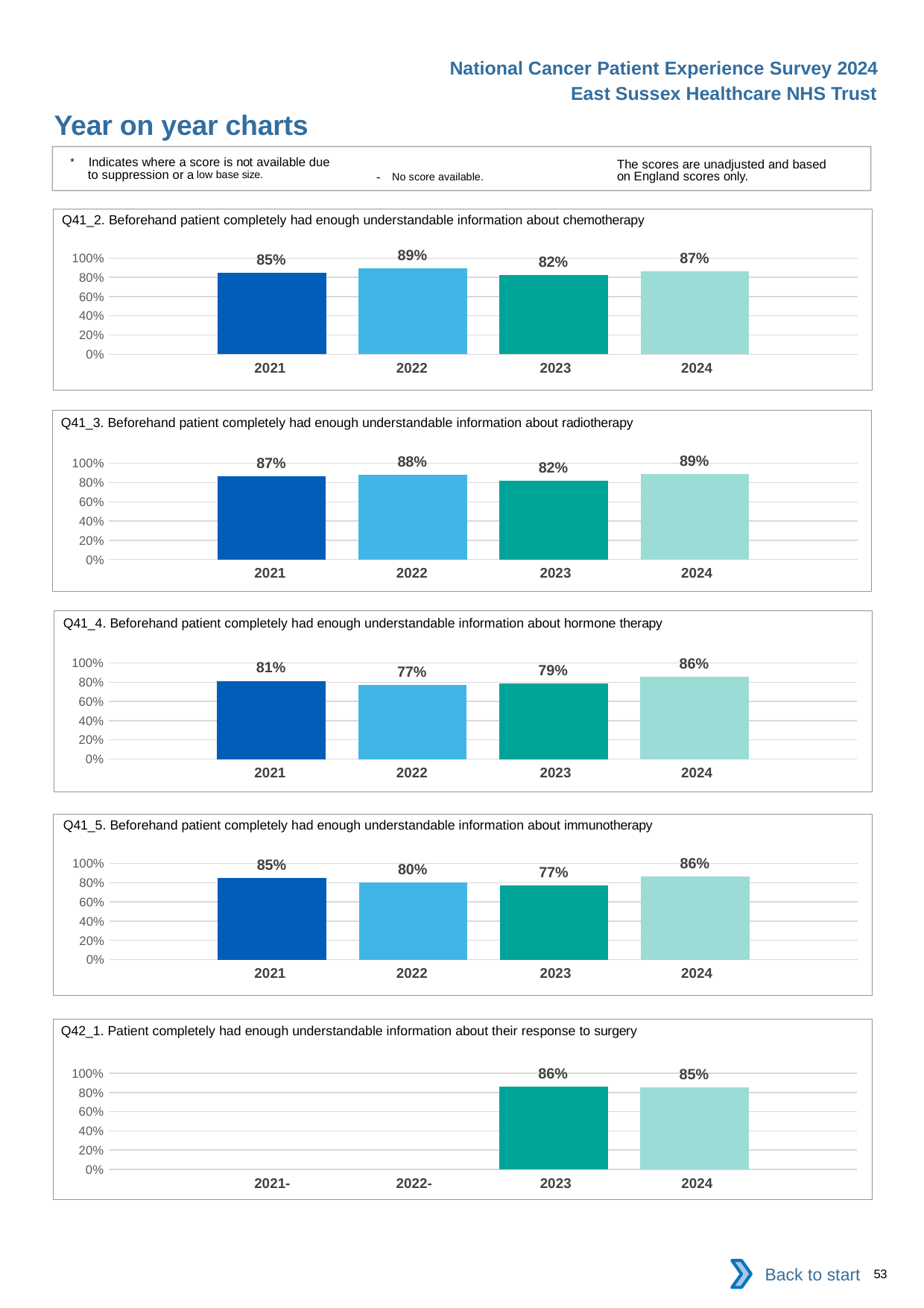
In the Q41_5 chart (immunotherapy), which is larger, the value for 2021 or the value for 2023? 2021 In the Q41_3 chart (radiotherapy), what is the value for 2024? 89% In the Q41_2 chart (chemotherapy), which year has the lowest value? 2023 In the Q41_3 chart (radiotherapy), what is the difference between the 2024 and 2023 values? 7 percentage points In the Q41_4 chart (hormone therapy), which year has the highest value? 2024 In the Q41_2 chart (chemotherapy), what is the value for 2022? 89% In the Q42_1 chart (response to surgery), what is the value for 2023? 86% In the Q41_5 chart (immunotherapy), what is the difference between the 2021 and 2022 values? 5 percentage points How many charts are shown on the slide? 5 What kind of chart is used for Q41_2 (chemotherapy)? Bar chart In the Q42_1 chart (response to surgery), how many years have a bar plotted? 2 In the Q41_4 chart (hormone therapy), what is the value for 2022? 77%